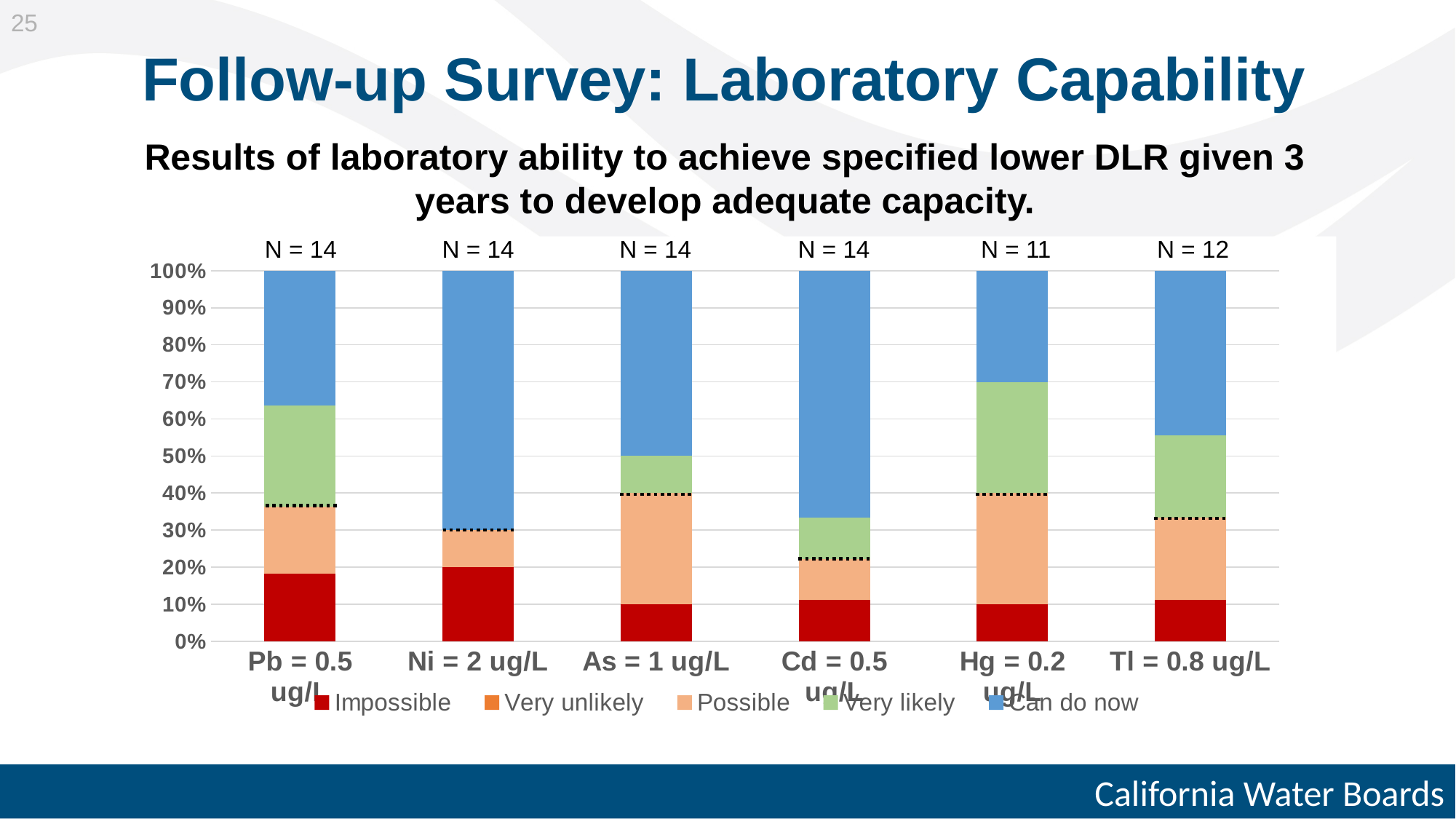
Is the 'Impossible' share for Pb = 0.5 ug/L greater or less than 10%? greater What is the N value shown above the Hg = 0.2 ug/L bar? N = 11 Which category has the smallest 'Very likely' share? Ni = 2 ug/L Is the 'Very likely' share for Hg = 0.2 ug/L greater or less than 20%? greater Which legend entry is shown in blue? Can do now What kind of chart is shown on the slide? Stacked bar chart Is the 'Can do now' share for Ni = 2 ug/L greater or less than 60%? greater How many contaminant categories are shown along the x axis? 6 How many series does the legend list? 5 What is the N value shown above the Pb = 0.5 ug/L bar? N = 14 What is the N value shown above the Tl = 0.8 ug/L bar? N = 12